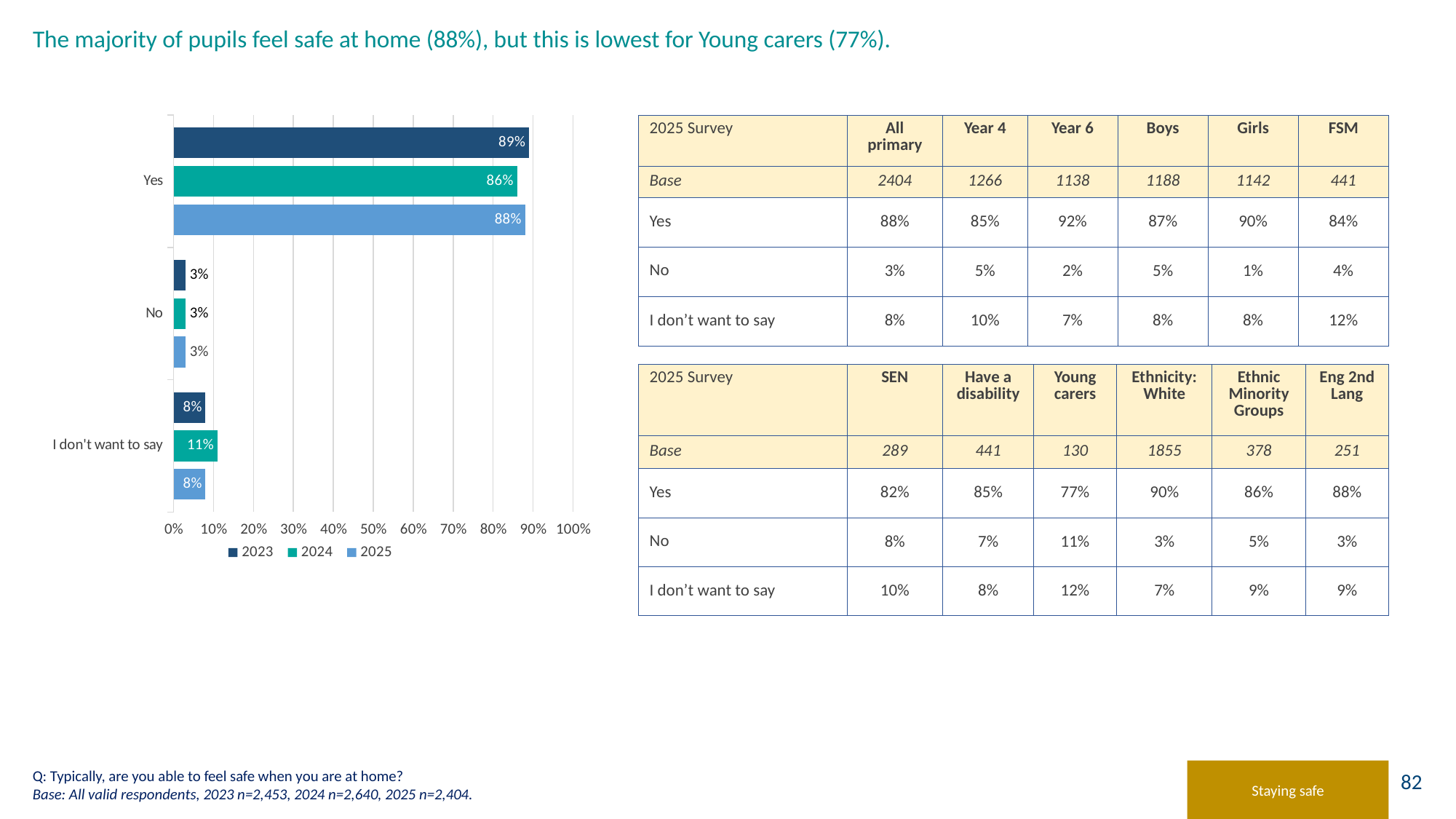
What kind of chart is shown on the slide? Bar chart In the bar chart, what is the difference between the 'Yes' values for 2023 and 2024? 3% In the bar chart, which year has the lowest value for 'Yes'? 2024 How many response categories are shown on the bar chart? 3 Which colour represents 2024 in the bar chart's legend? Teal/green What percentage of pupils answered 'Yes' in 2023 according to the bar chart? 89% What percentage of pupils answered 'I don't want to say' in 2024 according to the bar chart? 11% In the bar chart, is the 'I don't want to say' value larger in 2024 or in 2025? 2024 What percentage of pupils answered 'No' in 2025 according to the bar chart? 3% How many series does the bar chart's legend list? 3 In the bar chart, which year has the highest value for 'Yes'? 2023 What percentage of pupils answered 'Yes' in 2025 according to the bar chart? 88%